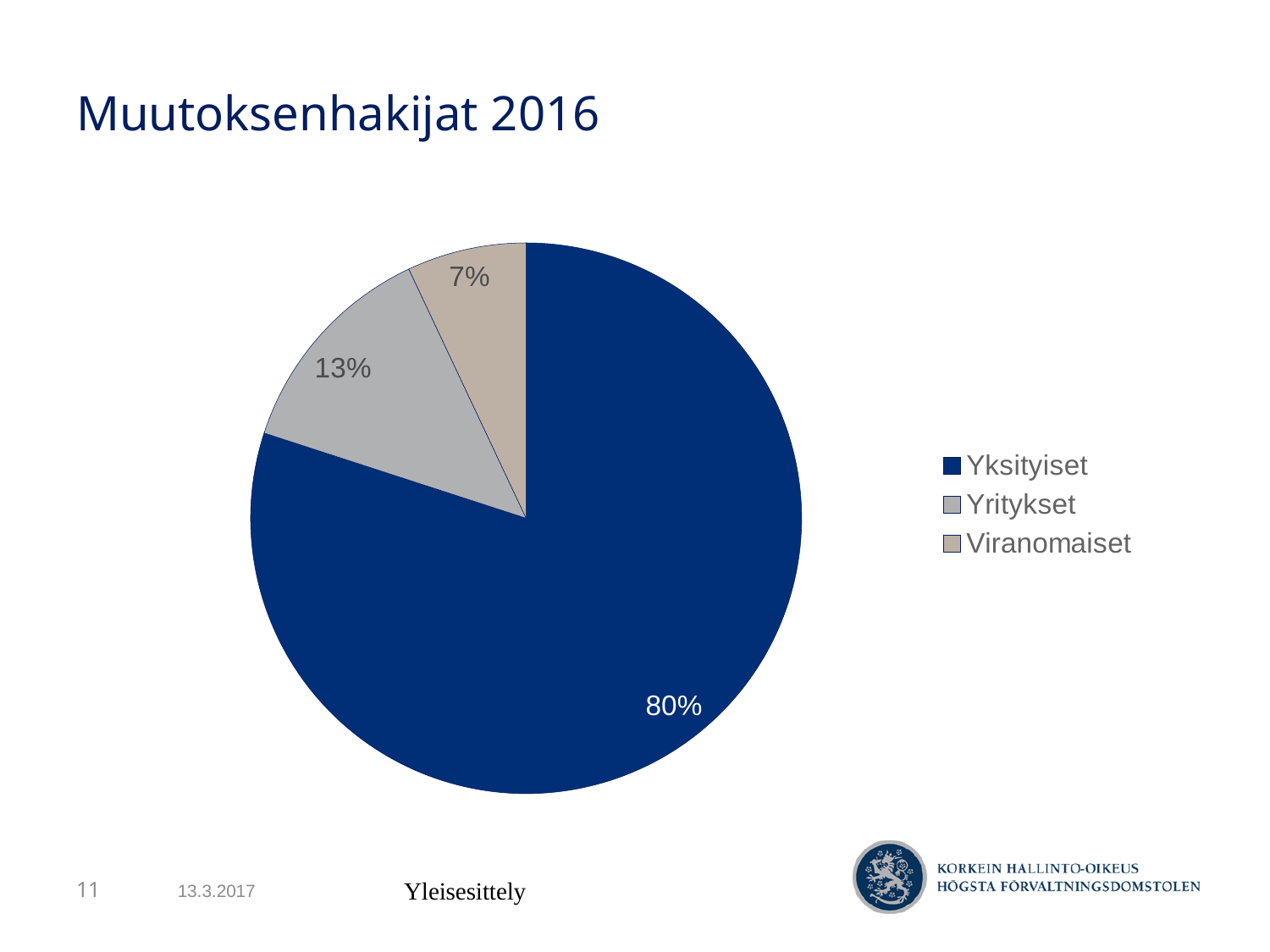
Which category has the largest slice of the pie? Yksityiset What is the difference in percentage points between Yksityiset and Yritykset? 67 Which is larger, the share for Yritykset or the share for Viranomaiset? Yritykset What share of the pie does Viranomaiset have? 7% What kind of chart is shown on the slide? pie chart How many slices does the pie chart have? 3 What share of the pie does Yksityiset have? 80% What is the difference in percentage points between Yritykset and Viranomaiset? 6 What is the title of the slide containing the chart? Muutoksenhakijat 2016 Which category is shown in dark blue in the legend? Yksityiset What share of the pie does Yritykset have? 13% Which category has the smallest slice of the pie? Viranomaiset